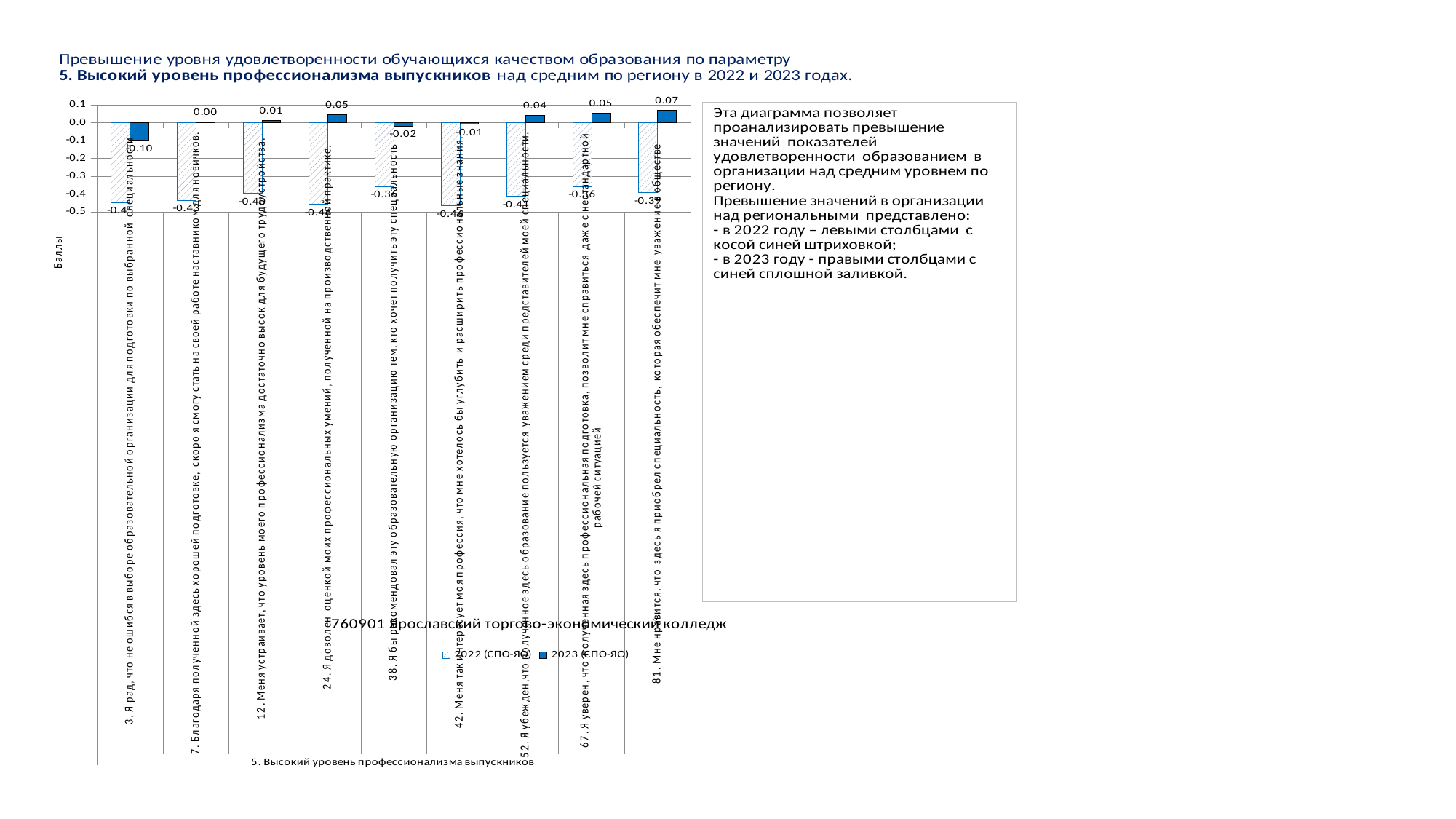
What is the 2023 (СПО-ЯО) value for statement 81 ("Мне нравится, что здесь я приобрел специальность...")? 0.07 What kind of chart is shown on the slide? Bar chart How many statements (categories) are shown on the x axis? 9 What is the 2023 (СПО-ЯО) value for statement 3 ("Я рад, что не ошибся в выборе образовательной организации...")? -0.10 What is the difference between the 2023 (СПО-ЯО) values for statement 81 and statement 67? 0.02 Is the 2022 (СПО-ЯО) value for statement 3 greater or less than -0.4? less Which statement has the lowest 2023 (СПО-ЯО) value? 3 Which statement has the highest 2023 (СПО-ЯО) value? 81 How many series does the legend list? 2 What is the 2023 (СПО-ЯО) value for statement 38 ("Я бы рекомендовал эту образовательную организацию...")? -0.02 Which is larger: the 2023 (СПО-ЯО) value for statement 24 or for statement 42? Statement 24 What is the 2023 (СПО-ЯО) value for statement 7 ("Благодаря полученной здесь хорошей подготовке...")? 0.00